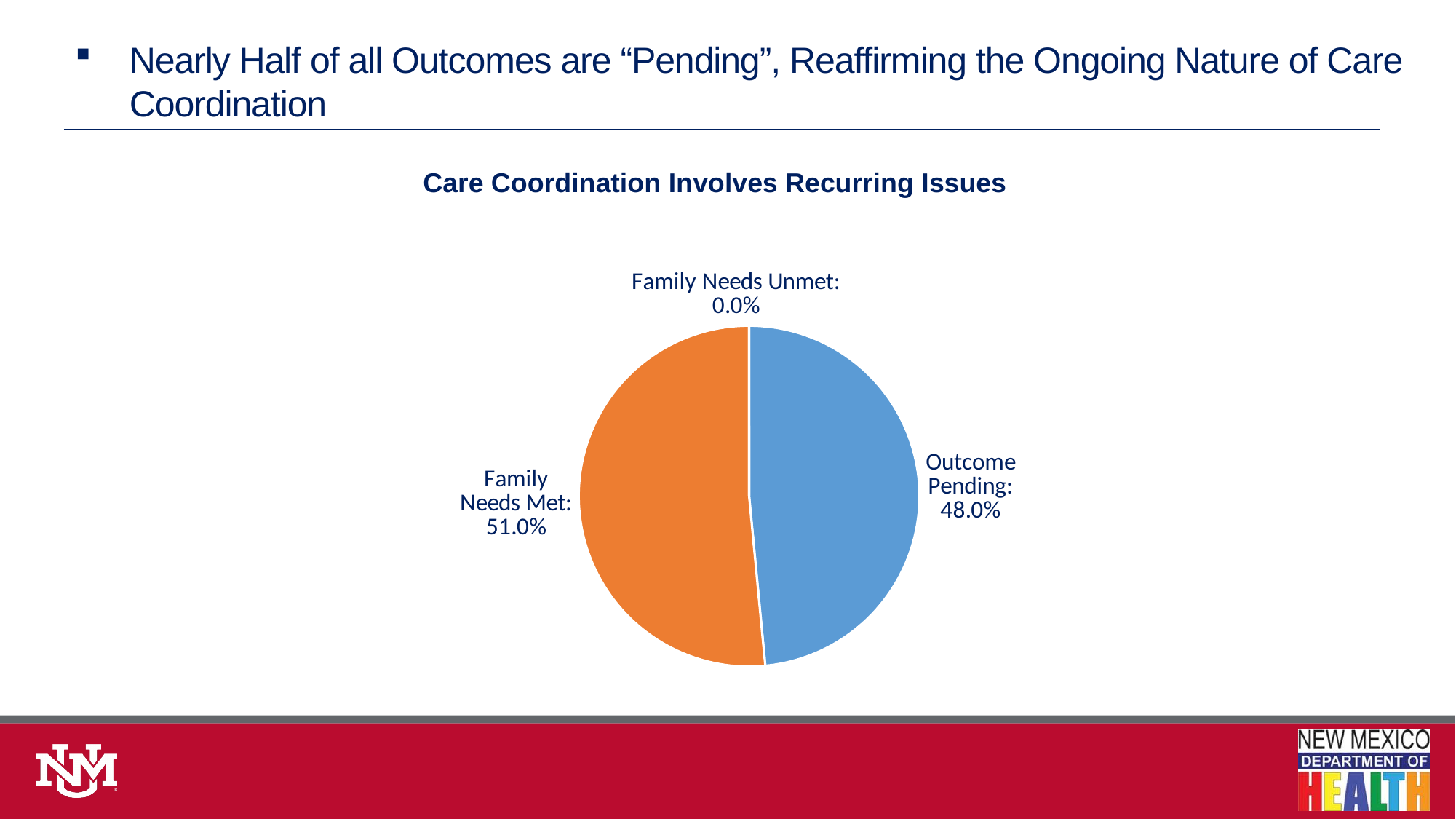
What is the title of the chart? Care Coordination Involves Recurring Issues What share of the pie is labelled Family Needs Unmet? 0.0% Which is larger, the share for Family Needs Met or the share for Outcome Pending? Family Needs Met What share of the pie is labelled Outcome Pending? 48.0% What colour is the Outcome Pending slice? Blue What kind of chart is shown on the slide? Pie chart What is the difference in percentage points between Family Needs Met and Outcome Pending? 3.0 Which category has the smallest share of the pie? Family Needs Unmet Which category has the largest share of the pie? Family Needs Met How many categories are labelled on the pie chart? 3 What share of the pie is labelled Family Needs Met? 51.0%